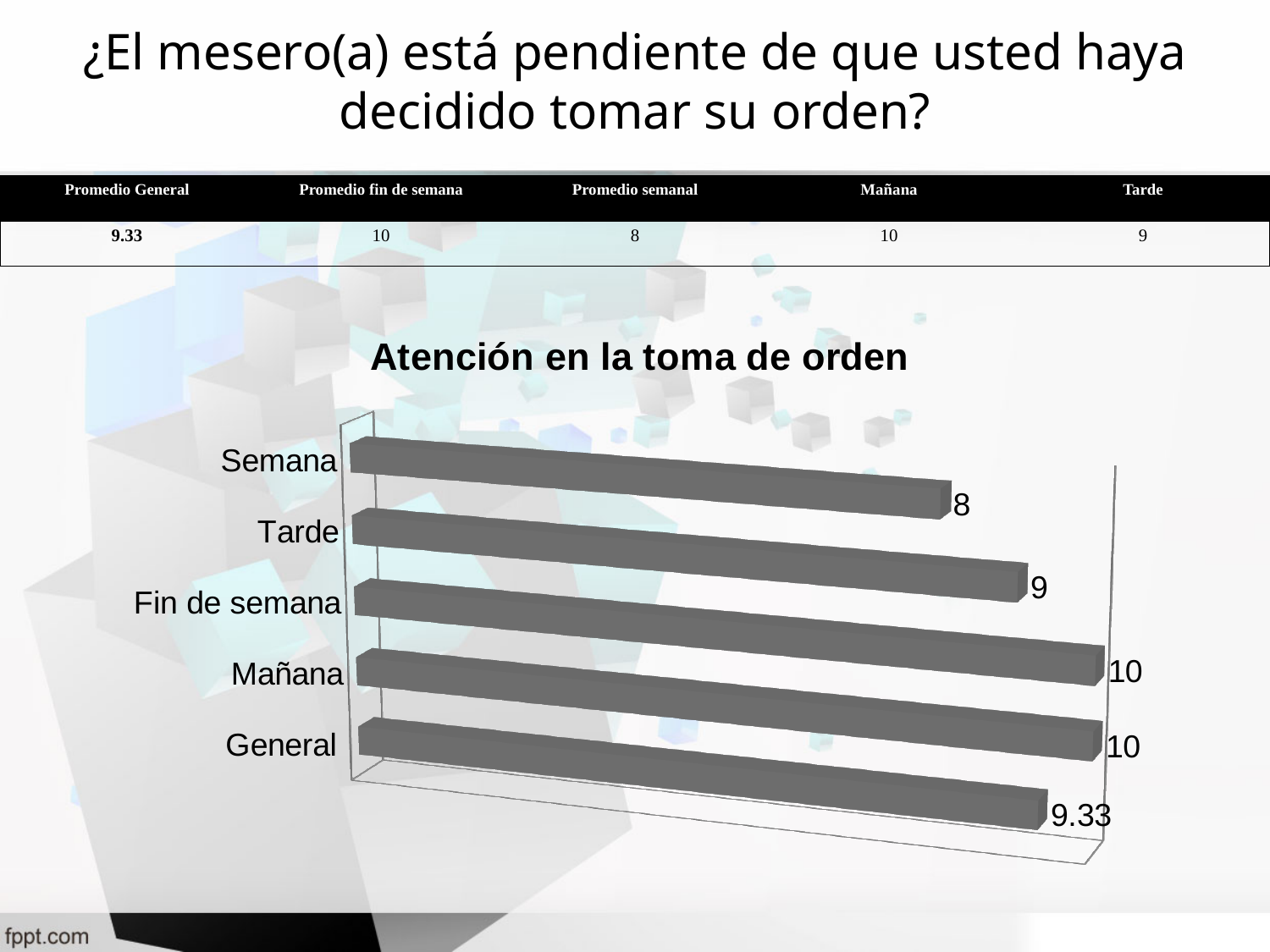
Which is larger, the value for Fin de semana or the value for General? Fin de semana What is the value for Tarde in the chart? 9 How many categories are shown in the chart? 5 What is the difference between the values for Tarde and Semana? 1 What is the value for General in the chart? 9.33 Which is larger, the value for Tarde or the value for Semana? Tarde What is the difference between the values for Mañana and Semana? 2 What type of chart is shown on the slide? Bar chart Which category has the lowest value in the chart? Semana What is the value for Fin de semana in the chart? 10 What is the value for Mañana in the chart? 10 What is the value for Semana in the chart? 8